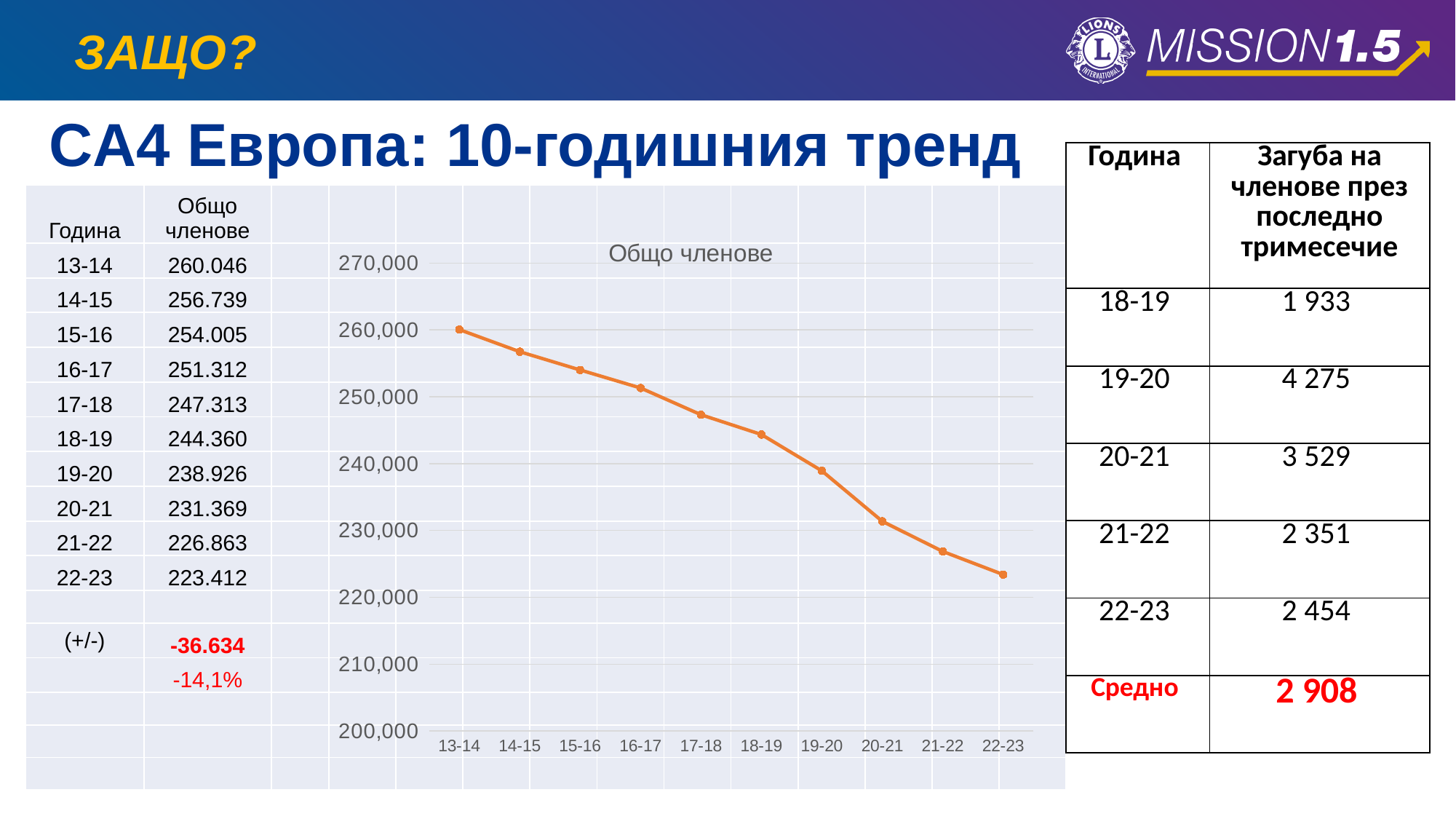
Do the values on the chart rise or fall from 13-14 to 22-23? fall Is the value for 20-21 greater or less than 240,000? less Which year has the highest value on the chart? 13-14 Which is larger, the value for 17-18 or the value for 19-20? 17-18 What type of chart is shown on the slide? line chart What is the value for 13-14 according to the table next to the chart? 260.046 What is the title of the chart? Общо членове What is the value for 22-23 according to the table next to the chart? 223.412 What is the value for 18-19 according to the table next to the chart? 244.360 Is the value for 16-17 greater or less than 250,000? greater Which year has the lowest value on the chart? 22-23 How many data points are plotted on the line chart? 10